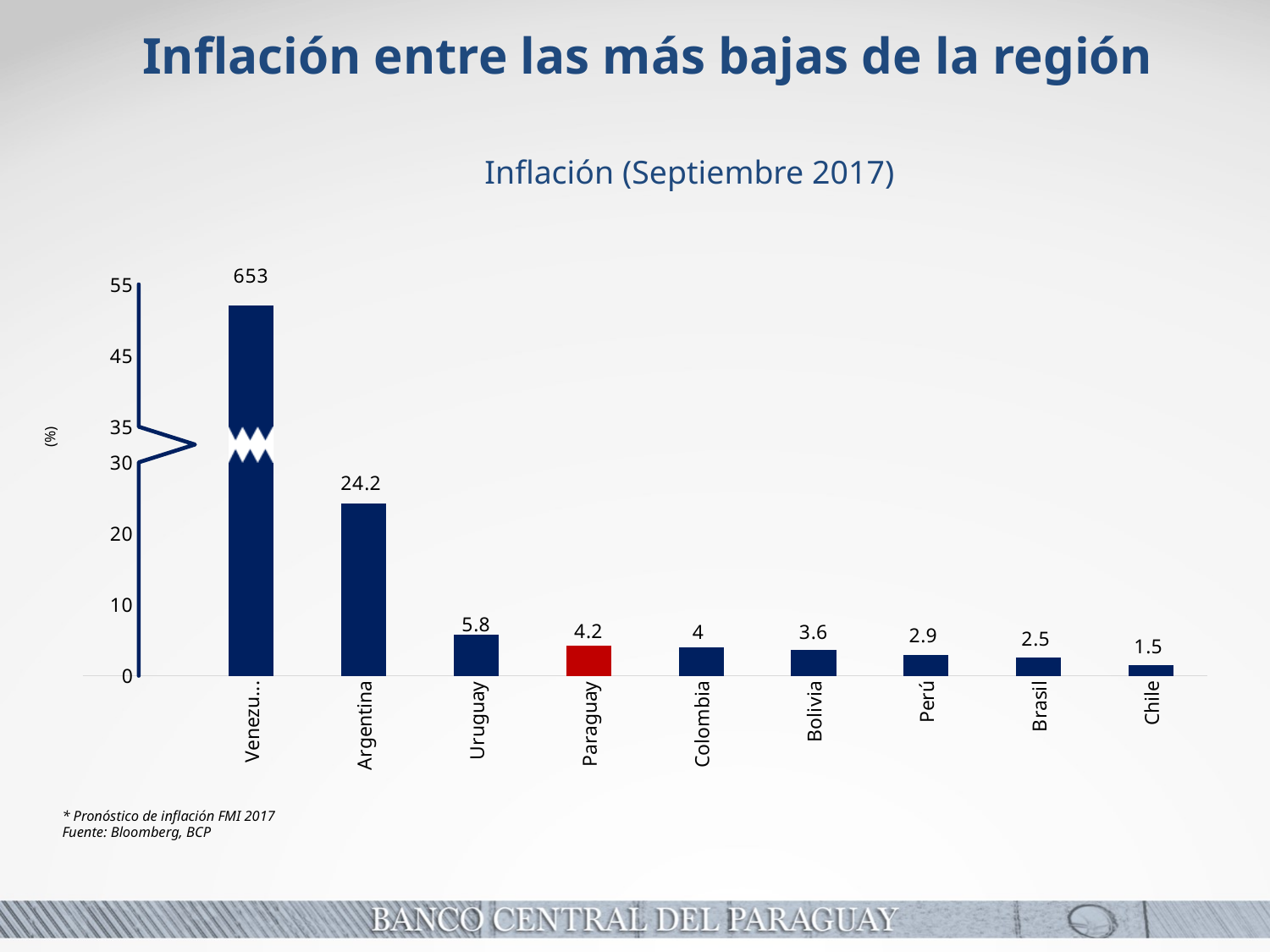
What kind of chart is shown on the slide? bar chart Which has a higher inflation value, Colombia or Bolivia? Colombia What is the inflation value shown for Argentina? 24.2 Which country has the lowest inflation in the chart? Chile What is the inflation value shown for Perú? 2.9 Is the value for Argentina greater or less than 20? greater How many countries are shown in the chart? 9 What is the difference between the inflation values of Brasil and Chile? 1 What is the difference between the inflation values of Uruguay and Paraguay? 1.6 Do the inflation values rise or fall from left to right along the x axis? fall What is the inflation value shown for Paraguay? 4.2 What is the inflation value shown for Chile? 1.5